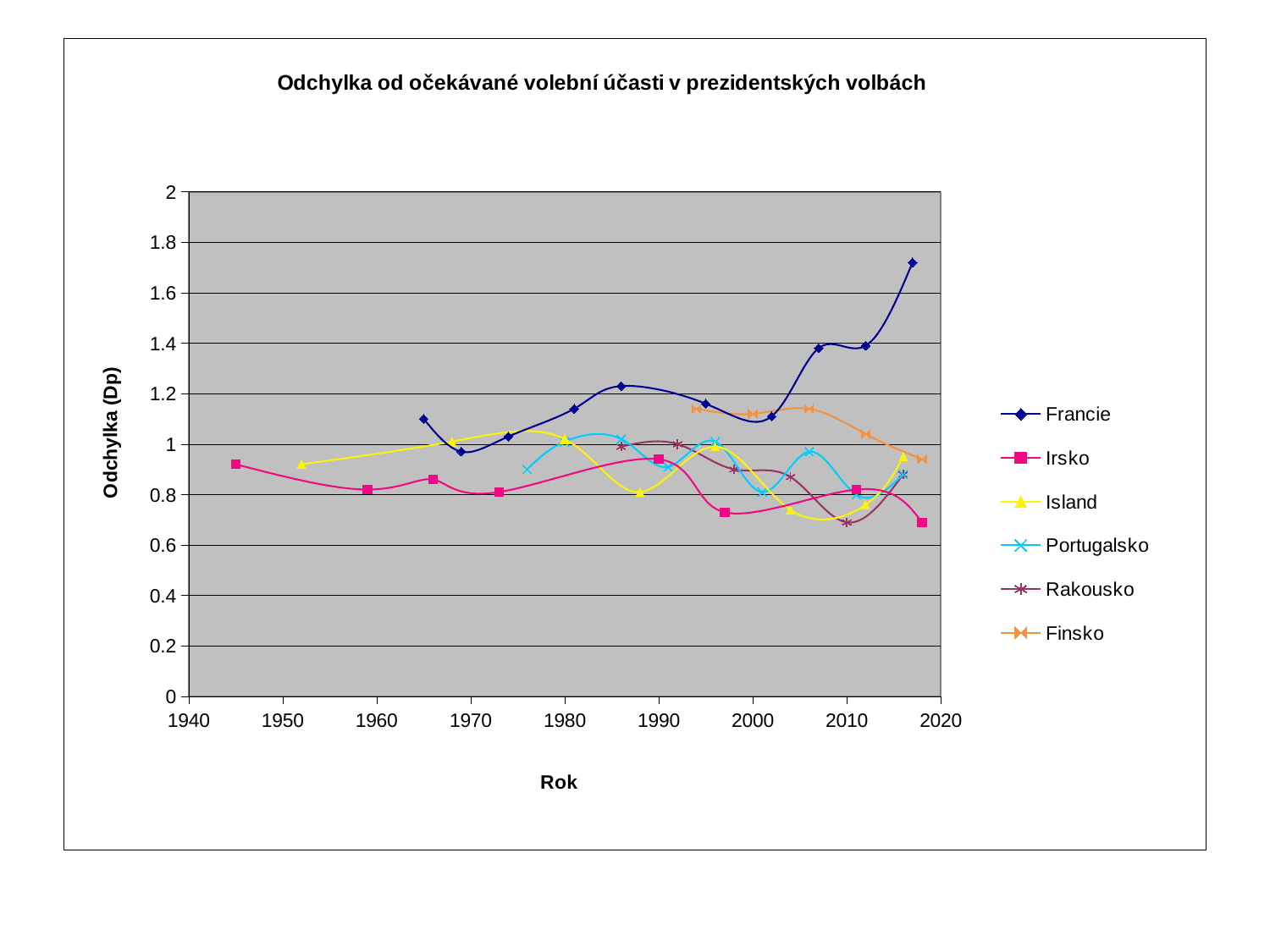
Is the first value for Irsko (around 1945) greater or less than 1? less Around 2017, which series has the higher value, Francie or Irsko? Francie Which series reaches the highest value on the chart? Francie Do the values for Francie rise or fall between 2002 and 2017? rise How many series does the legend list? 6 Around 2006, which series has the higher value, Finsko or Island? Finsko Is the highest value for Francie greater or less than 1.6? greater What is the title of the chart? Odchylka od očekávané volební účasti v prezidentských volbách What is the label of the vertical axis? Odchylka (Dp) How many data points are plotted for Francie? 10 Is the last value for Irsko (around 2018) greater or less than 0.8? less What kind of chart is shown on the slide? line chart